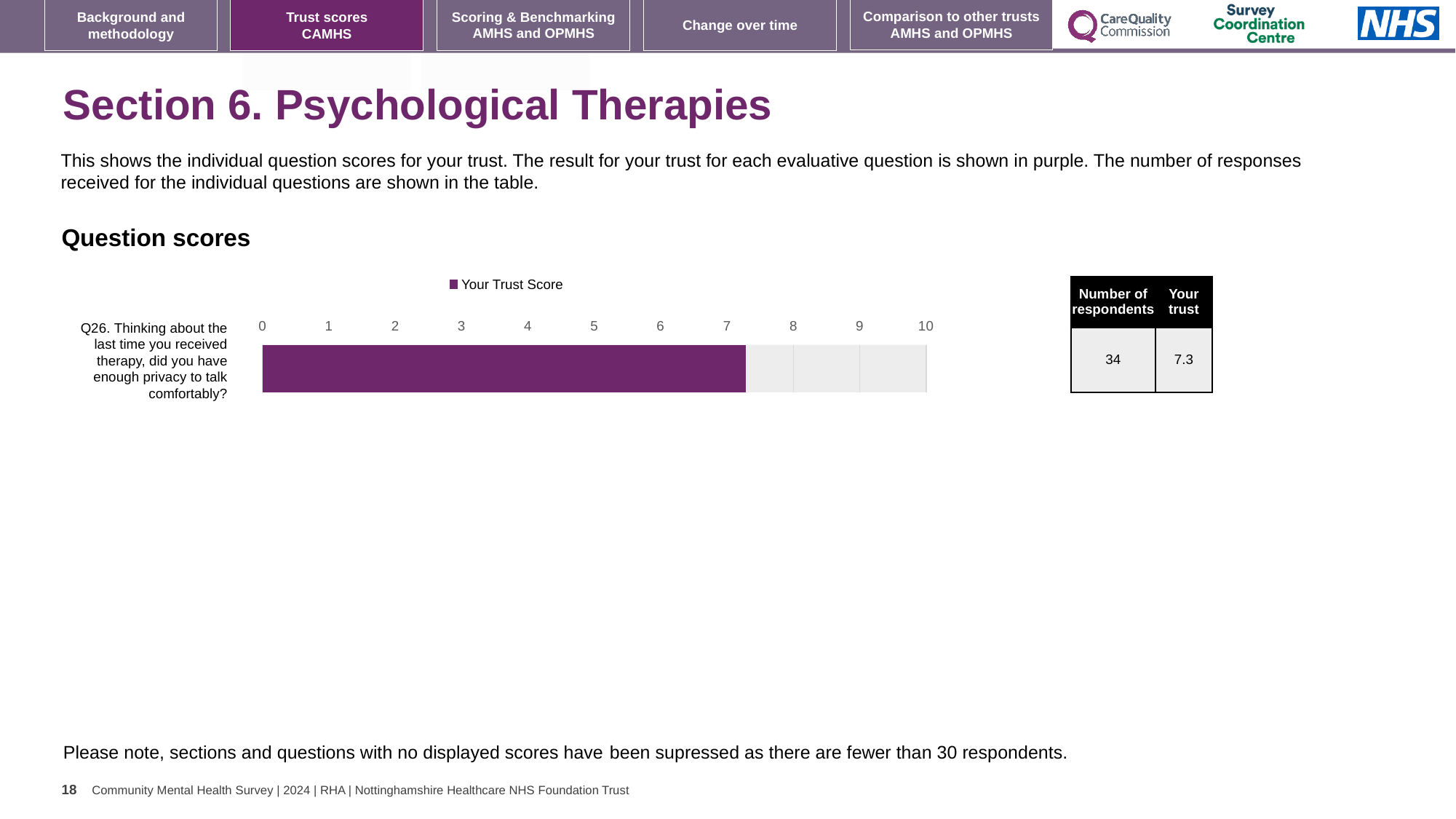
What is the trust score for Q26 (enough privacy to talk comfortably)? 7.3 Is the trust score for Q26 greater or less than 5? greater Is the trust score for Q26 greater or less than 8? less What is the maximum value shown on the x axis of the Question scores chart? 10 How many questions (categories) are plotted in the Question scores chart? 1 What kind of chart is shown under 'Question scores'? bar chart How many series does the legend of the Question scores chart list? 1 Is the trust score for Q26 greater or less than 6? greater How many respondents answered Q26 according to the table next to the chart? 34 What is the legend entry shown above the Question scores chart? Your Trust Score